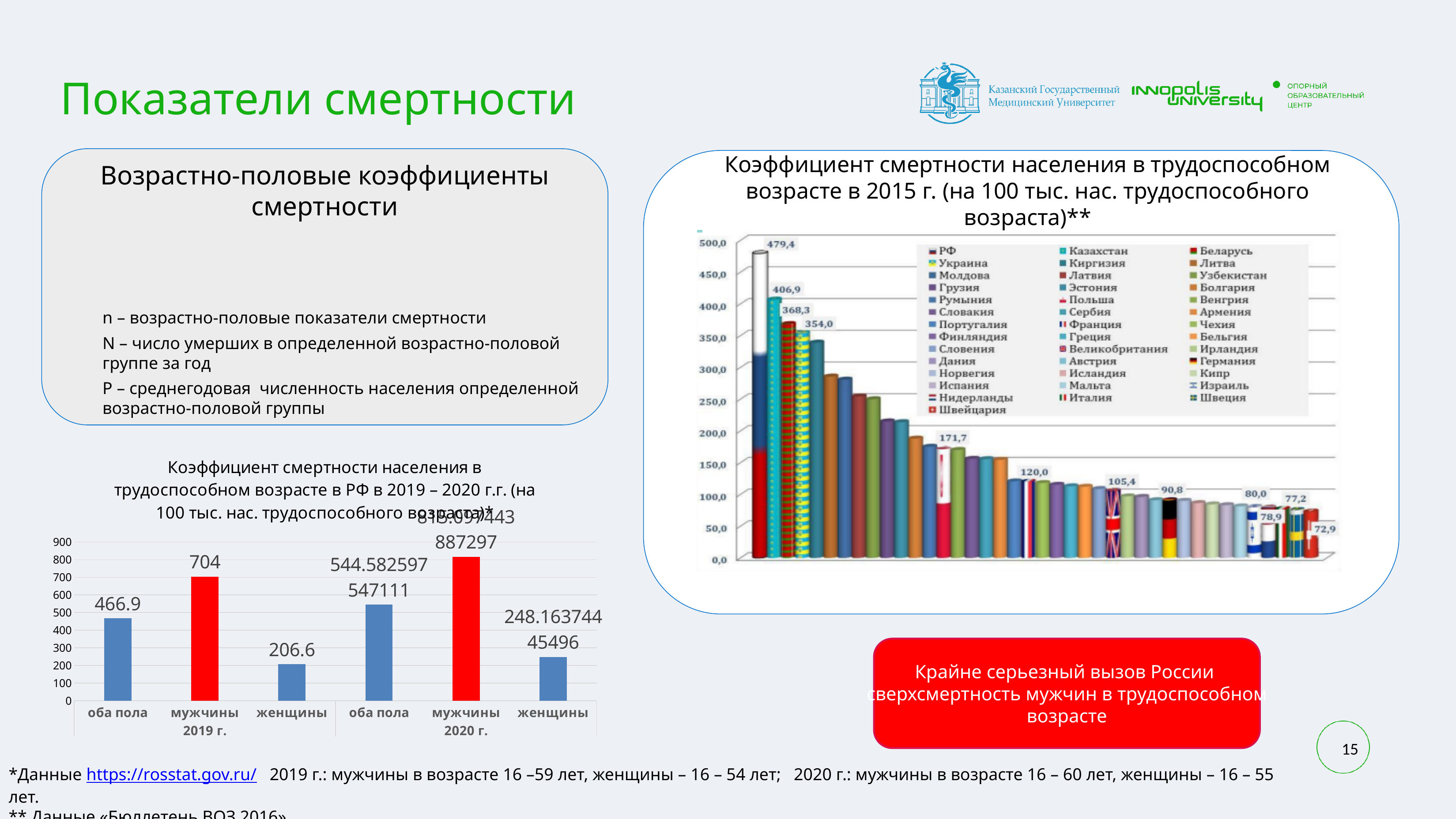
In the right chart (Коэффициент смертности населения в трудоспособном возрасте в 2015 г.), what is the value for РФ? 479,4 In the left chart (РФ 2019–2020), what is the difference between the values for мужчины and женщины in 2019 г.? 497.4 In the left chart (РФ 2019–2020), what is the value for оба пола in 2019 г.? 466.9 In the right chart (Коэффициент смертности населения в трудоспособном возрасте в 2015 г.), which country has the highest value? РФ What kind of chart is the left chart titled 'Коэффициент смертности населения в трудоспособном возрасте в РФ в 2019 – 2020 г.г.'? bar chart In the left chart (РФ 2019–2020), which category has the lowest value? женщины 2019 г. How many bars are plotted in the left chart (РФ 2019–2020)? 6 In the left chart (РФ 2019–2020), which category has the highest value? мужчины 2020 г. In the left chart (РФ 2019–2020), which is larger: the value for оба пола in 2019 г. or in 2020 г.? 2020 г. In the left chart (РФ 2019–2020), is the value for женщины in 2020 г. greater or less than 300? less In the left chart (РФ 2019–2020), what is the value for женщины in 2019 г.? 206.6 In the left chart (РФ 2019–2020), what is the value for мужчины in 2019 г.? 704